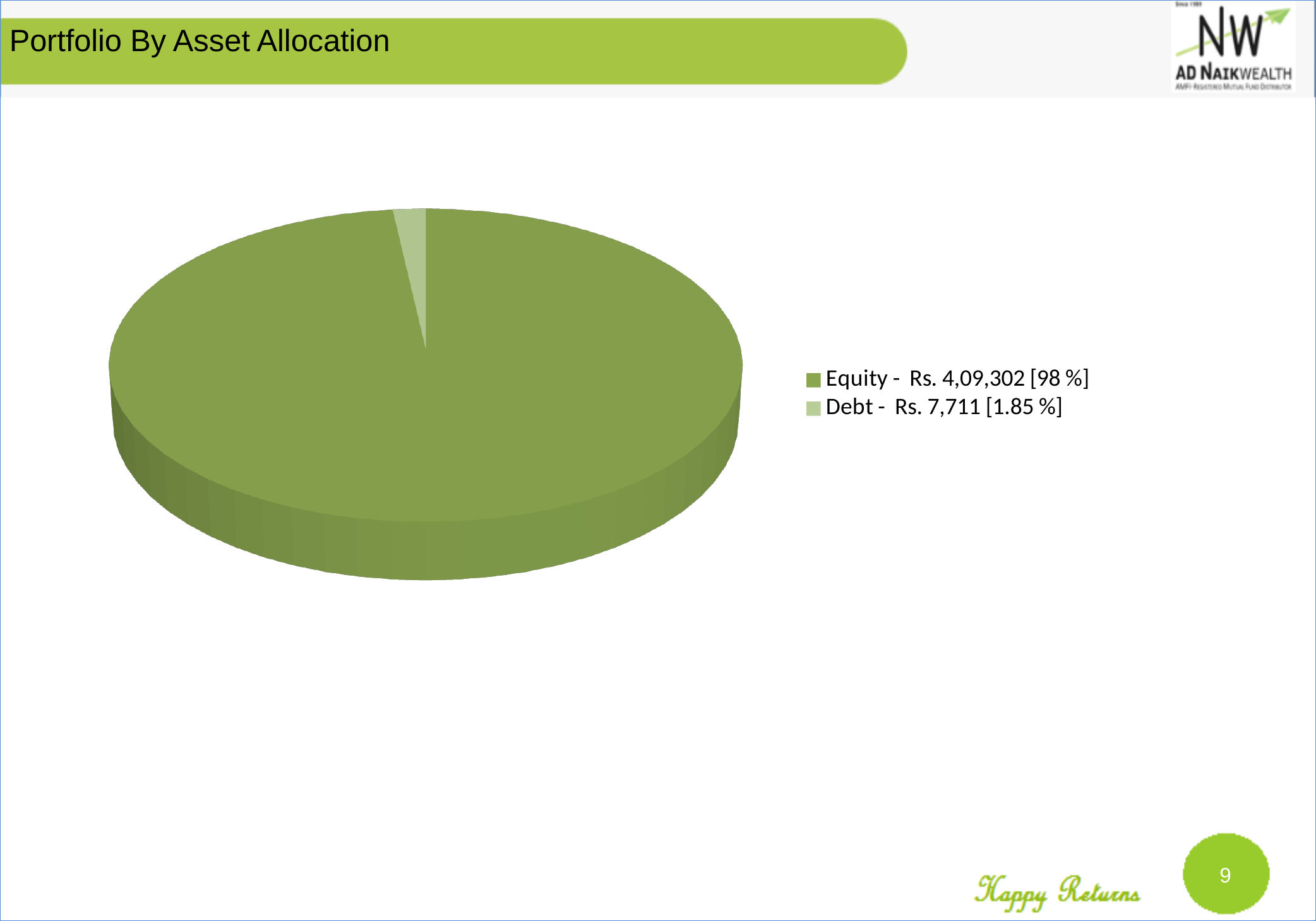
What is the value for Equity in the pie chart? Rs. 4,09,302 What kind of chart is shown on the slide? Pie chart How many entries does the legend list? 2 Which category has the largest slice of the pie? Equity Which category has the smallest slice of the pie? Debt What is the difference between the Equity value and the Debt value? Rs. 4,01,591 How many categories are shown in the pie chart? 2 What share of the pie does Debt represent? 1.85 % What is the title of the slide containing the pie chart? Portfolio By Asset Allocation What is the value for Debt in the pie chart? Rs. 7,711 What share of the pie does Equity represent? 98 % Which is larger, the value for Equity or the value for Debt? Equity